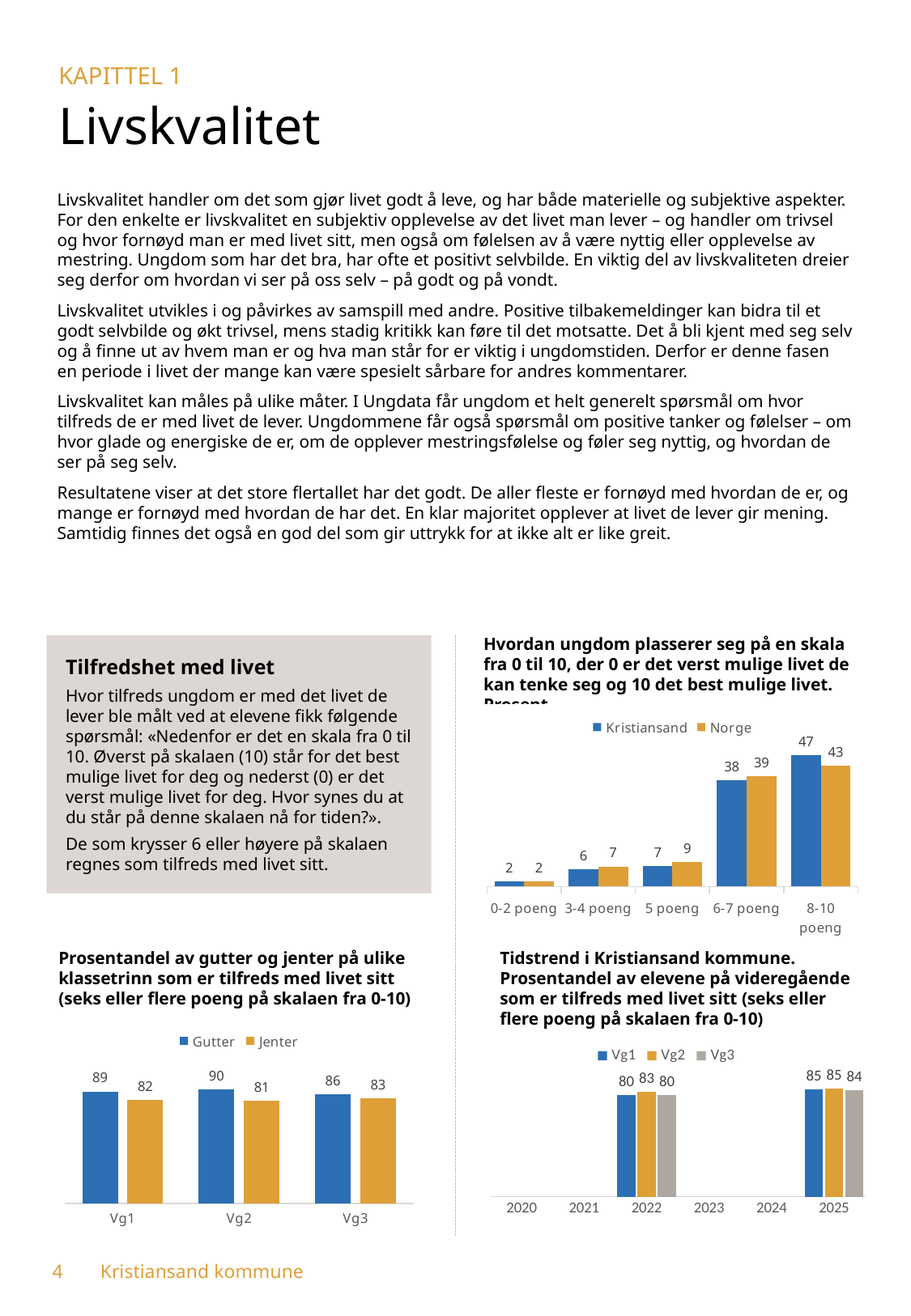
In the bottom-right chart (Tidstrend i Kristiansand kommune), what is the value for Vg2 in 2022? 83 In the top-right chart (Hvordan ungdom plasserer seg på en skala fra 0 til 10), which category has the highest value for Kristiansand? 8-10 poeng In the bottom-right chart (Tidstrend i Kristiansand kommune), how many series does the legend list? 3 In the bottom-left chart (Prosentandel av gutter og jenter på ulike klassetrinn som er tilfreds med livet sitt), which class level has the lowest value for Jenter? Vg2 In the top-right chart (Hvordan ungdom plasserer seg på en skala fra 0 til 10), what is the value for Norge in the 6-7 poeng category? 39 In the bottom-left chart (Prosentandel av gutter og jenter på ulike klassetrinn som er tilfreds med livet sitt), what is the value for Gutter in Vg2? 90 In the top-right chart (Hvordan ungdom plasserer seg på en skala fra 0 til 10), how many categories are shown on the x axis? 5 In the bottom-left chart (Prosentandel av gutter og jenter på ulike klassetrinn som er tilfreds med livet sitt), which is larger in Vg1: Gutter or Jenter? Gutter In the top-right chart (Hvordan ungdom plasserer seg på en skala fra 0 til 10), which series does the legend list besides Kristiansand? Norge In the bottom-left chart (Prosentandel av gutter og jenter på ulike klassetrinn som er tilfreds med livet sitt), what kind of chart is it? Bar chart In the top-right chart (Hvordan ungdom plasserer seg på en skala fra 0 til 10), what is the difference between Kristiansand and Norge in the 8-10 poeng category? 4 In the top-right chart (Hvordan ungdom plasserer seg på en skala fra 0 til 10), what is the value for Kristiansand in the 8-10 poeng category? 47